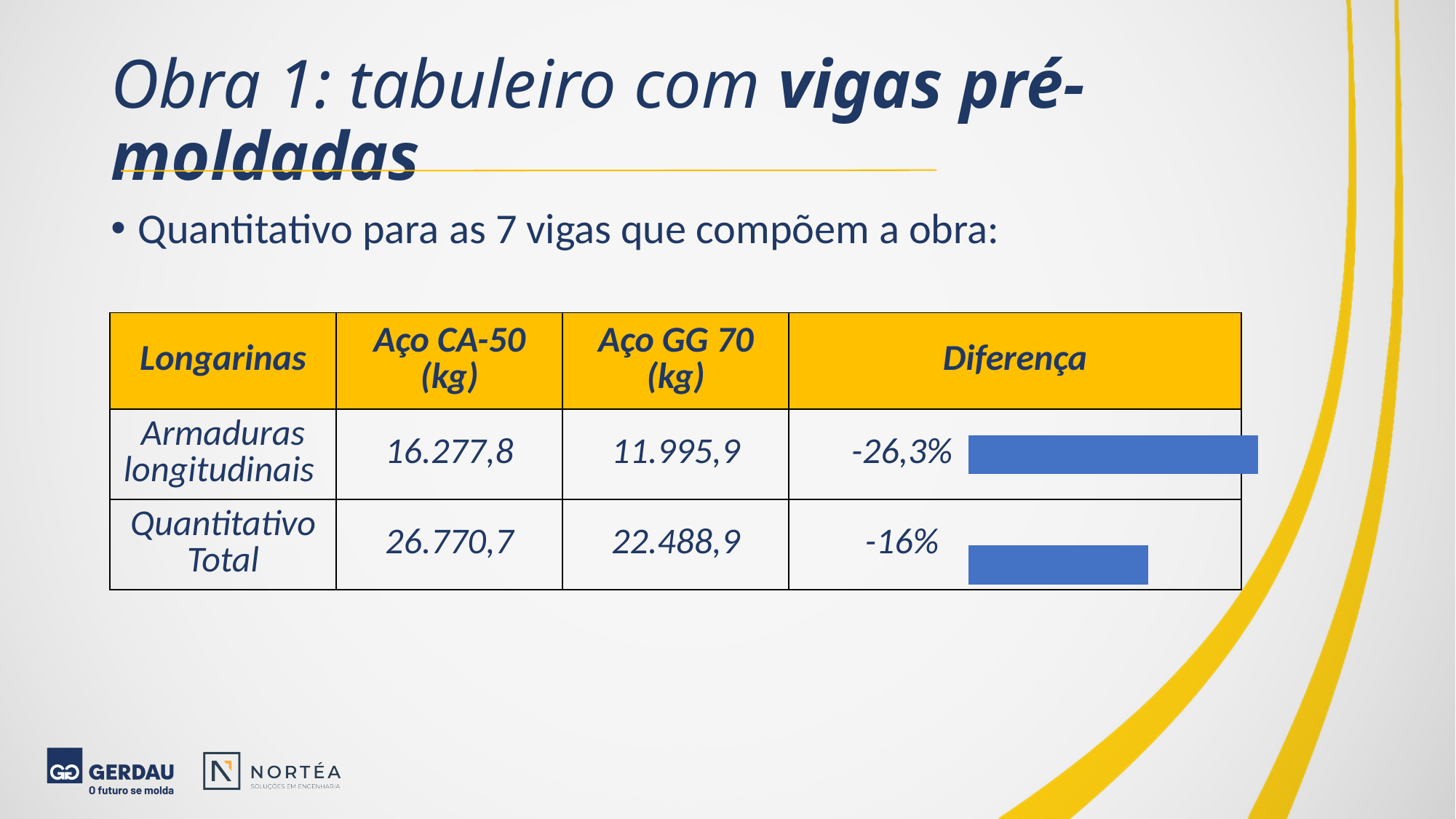
Is the Diferença bar for Armaduras longitudinais longer or shorter than the bar for Quantitativo Total? longer Which row has the shorter bar in the Diferença column? Quantitativo Total Which row has the longer bar in the Diferença column? Armaduras longitudinais What is the Aço CA-50 (kg) value for Armaduras longitudinais? 16.277,8 What is the Diferença value shown for Quantitativo Total? -16% By how many percentage points does the Diferença for Armaduras longitudinais (-26,3%) exceed in magnitude the Diferença for Quantitativo Total (-16%)? 10,3 What kind of chart is shown in the Diferença column of the table? bar chart How many bars are plotted in the Diferença column? 2 What colour are the bars in the Diferença column? blue What is the Diferença value shown for Armaduras longitudinais? -26,3% What is the Aço GG 70 (kg) value for Quantitativo Total? 22.488,9 Which is larger for Quantitativo Total: the Aço CA-50 (kg) value or the Aço GG 70 (kg) value? Aço CA-50 (kg)